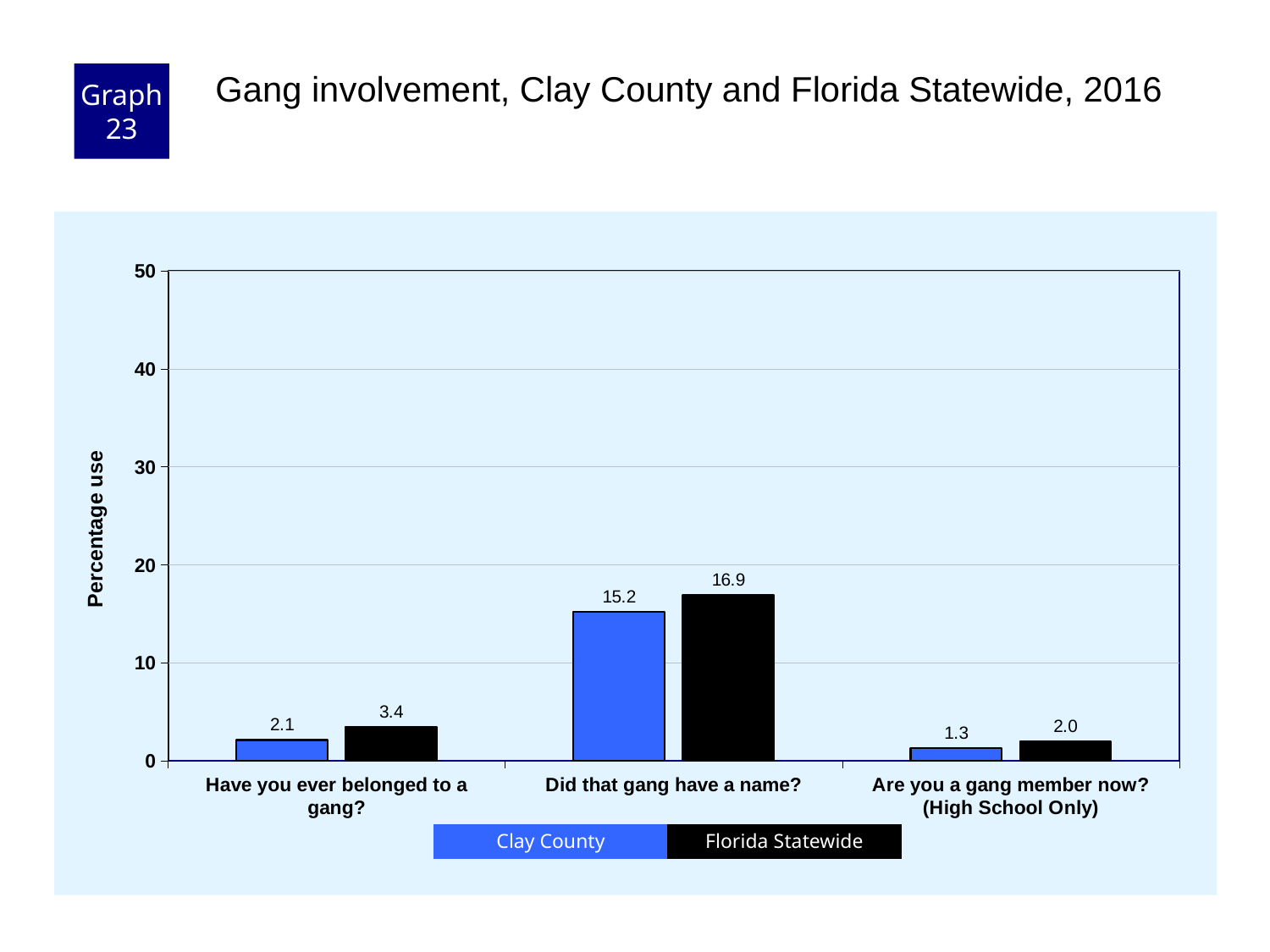
How many series does the legend list? 2 For "Have you ever belonged to a gang?", which is larger: Clay County or Florida Statewide? Florida Statewide What is the label of the y axis? Percentage use Which question has the lowest Clay County value? Are you a gang member now? (High School Only) What is the Florida Statewide value for "Have you ever belonged to a gang?"? 3.4 How many question categories are shown on the x axis? 3 What is the Clay County value for "Did that gang have a name?"? 15.2 What kind of chart is shown on the slide? Bar chart Which question has the highest Florida Statewide value? Did that gang have a name? What is the difference between the Florida Statewide and Clay County values for "Did that gang have a name?"? 1.7 Is the Florida Statewide value for "Did that gang have a name?" greater or less than 20? less What is the Clay County value for "Are you a gang member now? (High School Only)"? 1.3